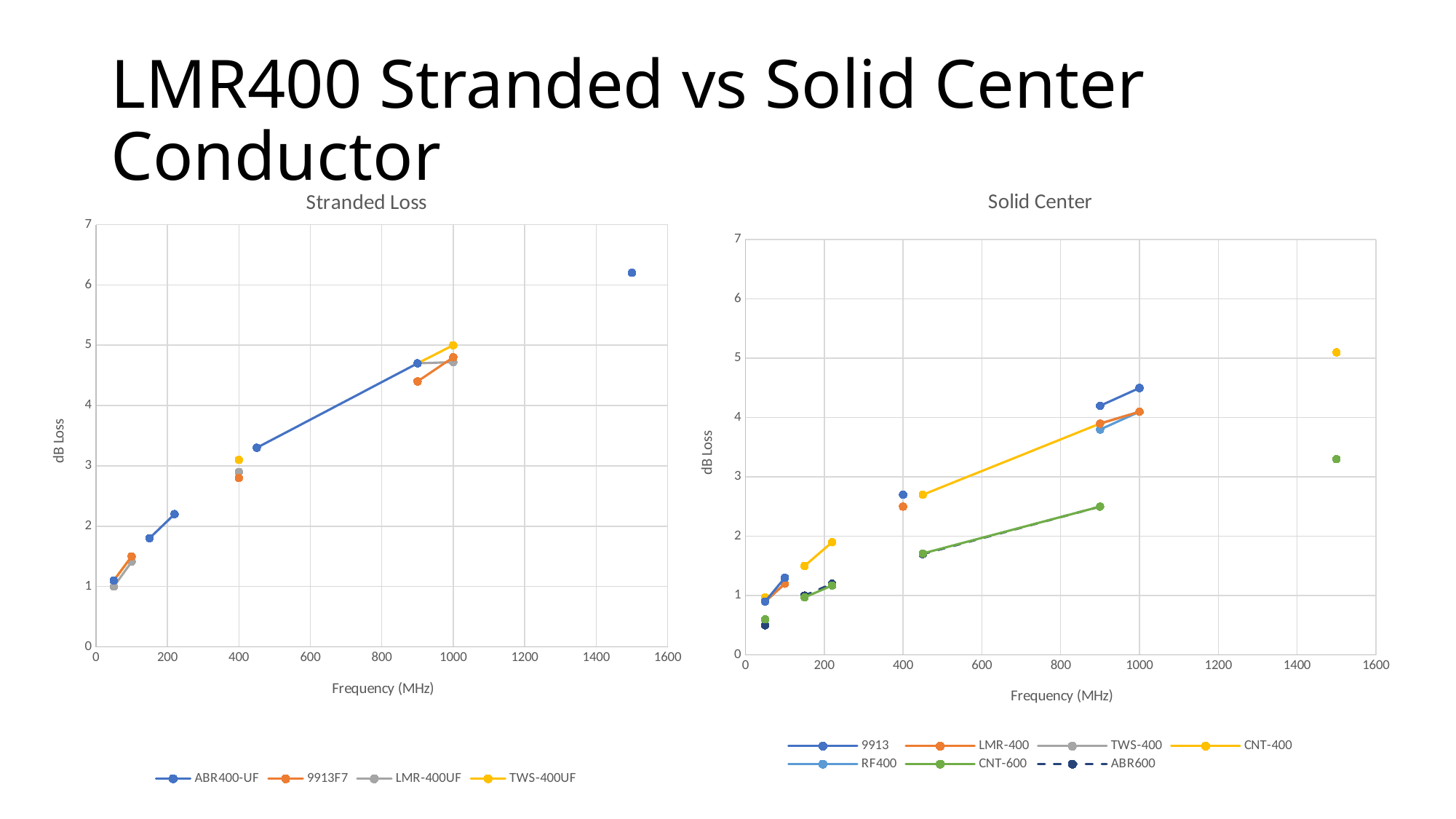
What is the x-axis label of the Solid Center chart? Frequency (MHz) In the Stranded Loss chart, is the value for 9913F7 at 900 MHz greater or less than 4? greater How many series does the legend of the Stranded Loss chart list? 4 In the Stranded Loss chart, is the value for ABR400-UF at 1500 MHz greater or less than 6? greater In the Stranded Loss chart, is the value for ABR400-UF at 450 MHz greater or less than 3? greater What is the y-axis label of the Stranded Loss chart? dB Loss In the Solid Center chart, do the dB Loss values rise or fall as frequency increases? rise What kind of chart is the Stranded Loss chart? line chart How many series does the legend of the Solid Center chart list? 7